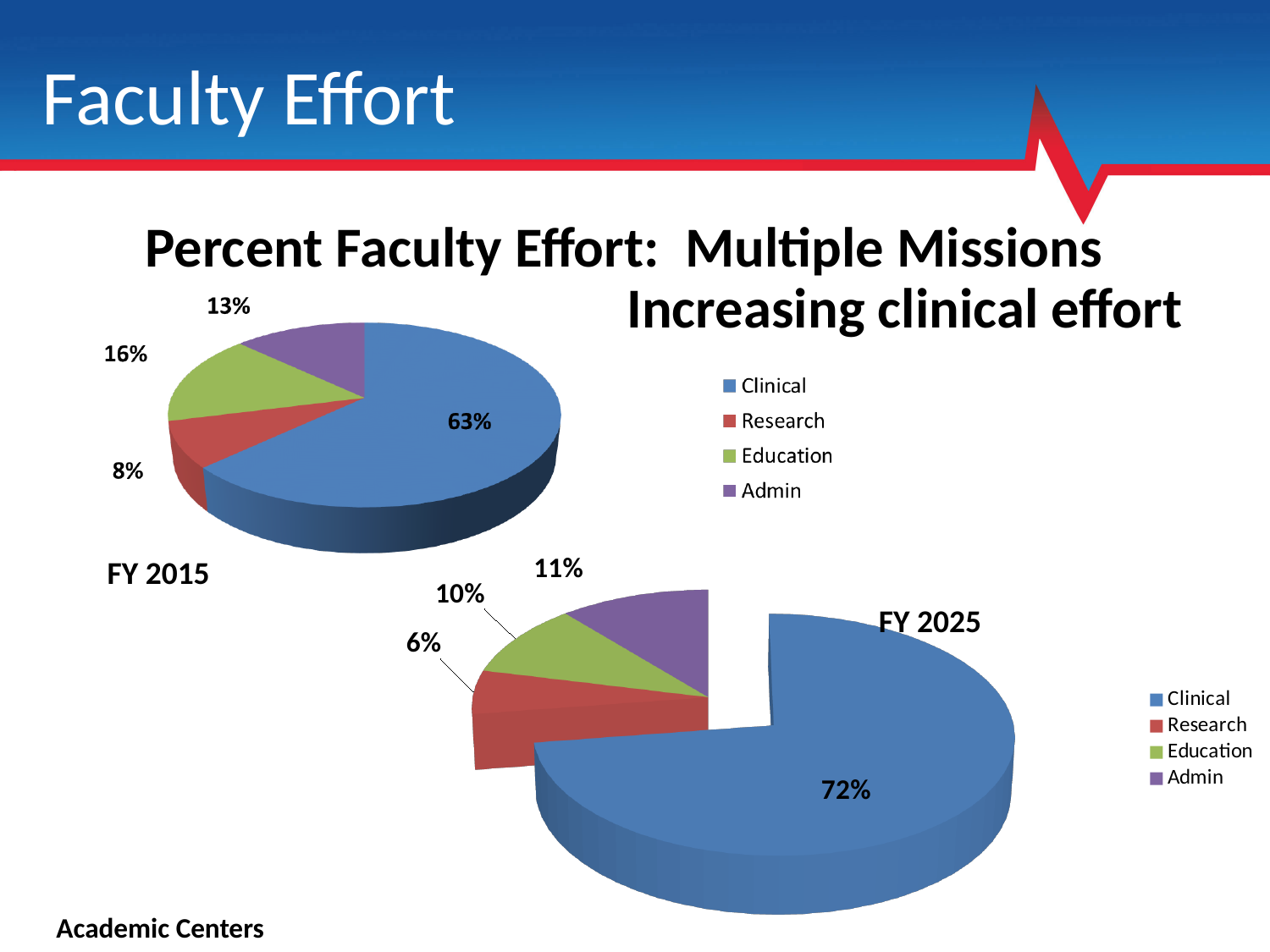
In the FY 2025 pie chart, what percentage is shown for Research? 6% In the FY 2015 pie chart, which category has the smallest share? Research How many categories does the legend of the FY 2025 pie chart list? 4 In the FY 2015 pie chart, what percentage is shown for Education? 16% What type of chart is used for FY 2015? Pie chart In the FY 2015 pie chart, which is larger, the Education share or the Admin share? Education How much larger is the Clinical share in the FY 2025 pie chart than in the FY 2015 pie chart? 9 percentage points In the FY 2015 pie chart, what percentage is shown for Clinical? 63% In the FY 2025 pie chart, which category has the largest share? Clinical What colour represents Admin in the FY 2015 pie chart? Purple In the FY 2025 pie chart, what percentage is shown for Clinical? 72% In the FY 2025 pie chart, what is the difference between the Admin share and the Education share? 1 percentage point